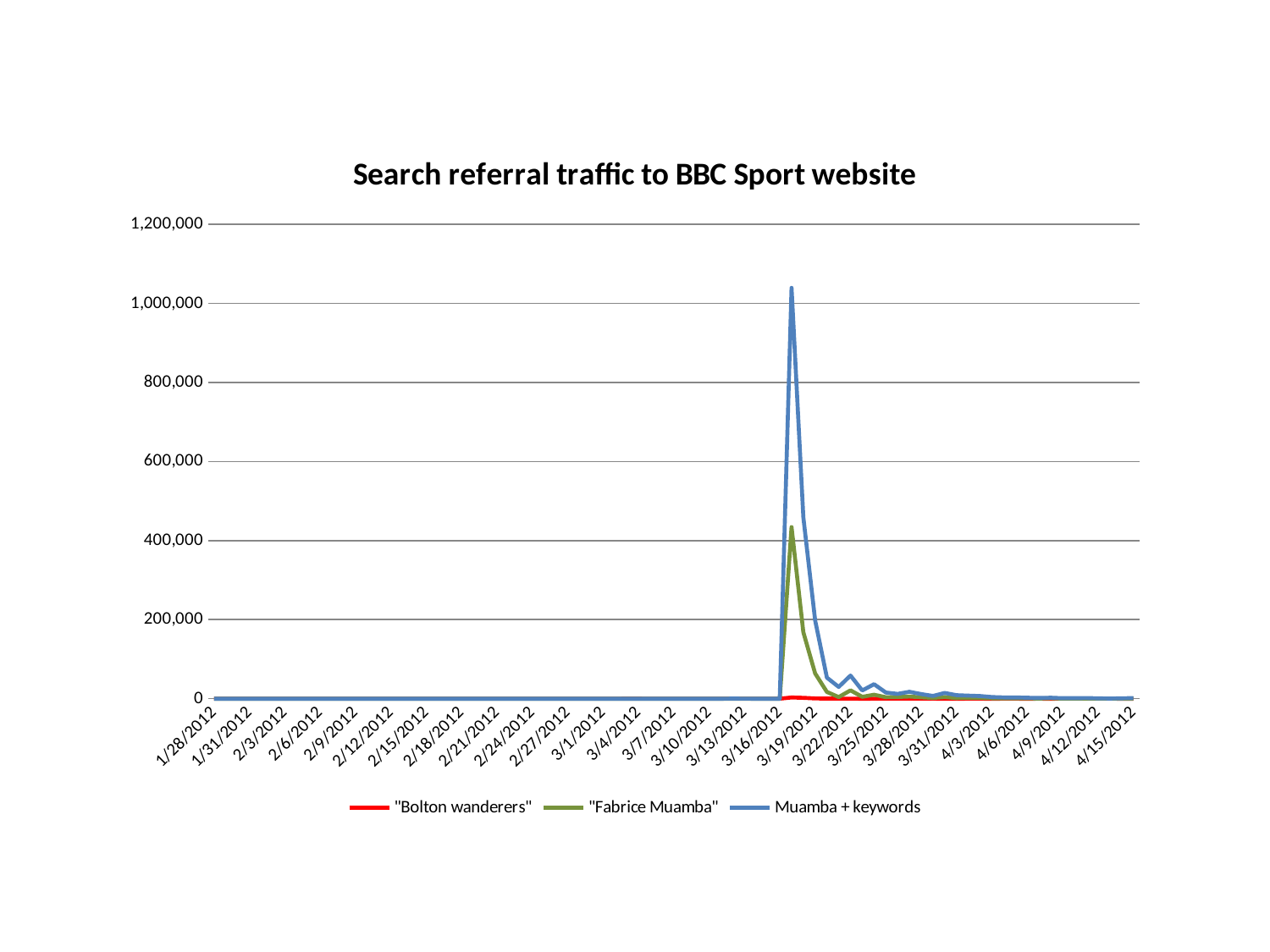
Which series is drawn in blue? Muamba + keywords Which series has the lowest peak on the chart? "Bolton wanderers" Is the peak value of "Fabrice Muamba" greater or less than 600,000? less Is the value for Muamba + keywords on 2/15/2012 greater or less than 200,000? less How many series does the legend list? 3 What kind of chart is shown on the slide? Line chart Is the peak value of Muamba + keywords greater or less than 1,000,000? greater After the spike around mid-March, do the values for Muamba + keywords rise or fall toward 4/15/2012? fall What is the title of the chart? Search referral traffic to BBC Sport website Which series reaches the highest value on the chart? Muamba + keywords Which series has the higher peak, "Fabrice Muamba" or "Bolton wanderers"? "Fabrice Muamba"